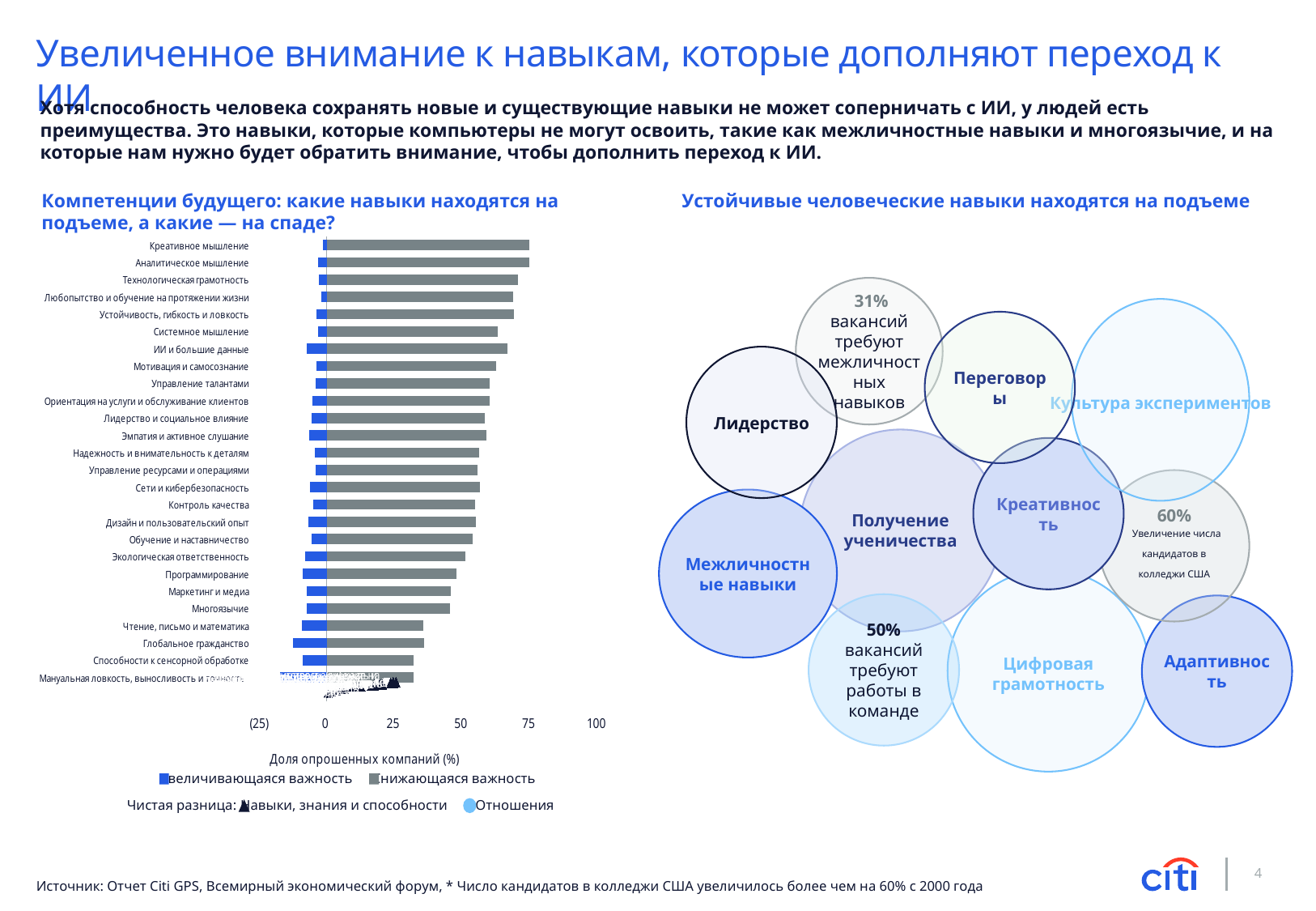
What kind of chart is shown under the title "Компетенции будущего: какие навыки находятся на подъеме, а какие — на спаде?"? Bar chart In the bar chart on the left, how many skill categories are listed on the vertical axis? 26 In the bar chart on the left, is the grey bar for "Системное мышление" greater or less than 50? greater In the bar chart on the left, is the grey bar for "Способности к сенсорной обработке" greater or less than 50? less In the bar chart on the left, what colour are the bars for "Увеличивающаяся важность"? Blue In the bar chart on the left, is the grey bar for "Чтение, письмо и математика" greater or less than 50? less In the bar chart on the left, which has the longer grey bar: "Технологическая грамотность" or "Многоязычие"? Технологическая грамотность In the bar chart on the left, what is the title of the horizontal axis? Доля опрошенных компаний (%) In the bar chart on the left, do the grey bars generally get longer or shorter moving down the list from "Креативное мышление" to "Мануальная ловкость"? shorter In the bar chart on the left, which has the longer grey bar: "Креативное мышление" or "Чтение, письмо и математика"? Креативное мышление